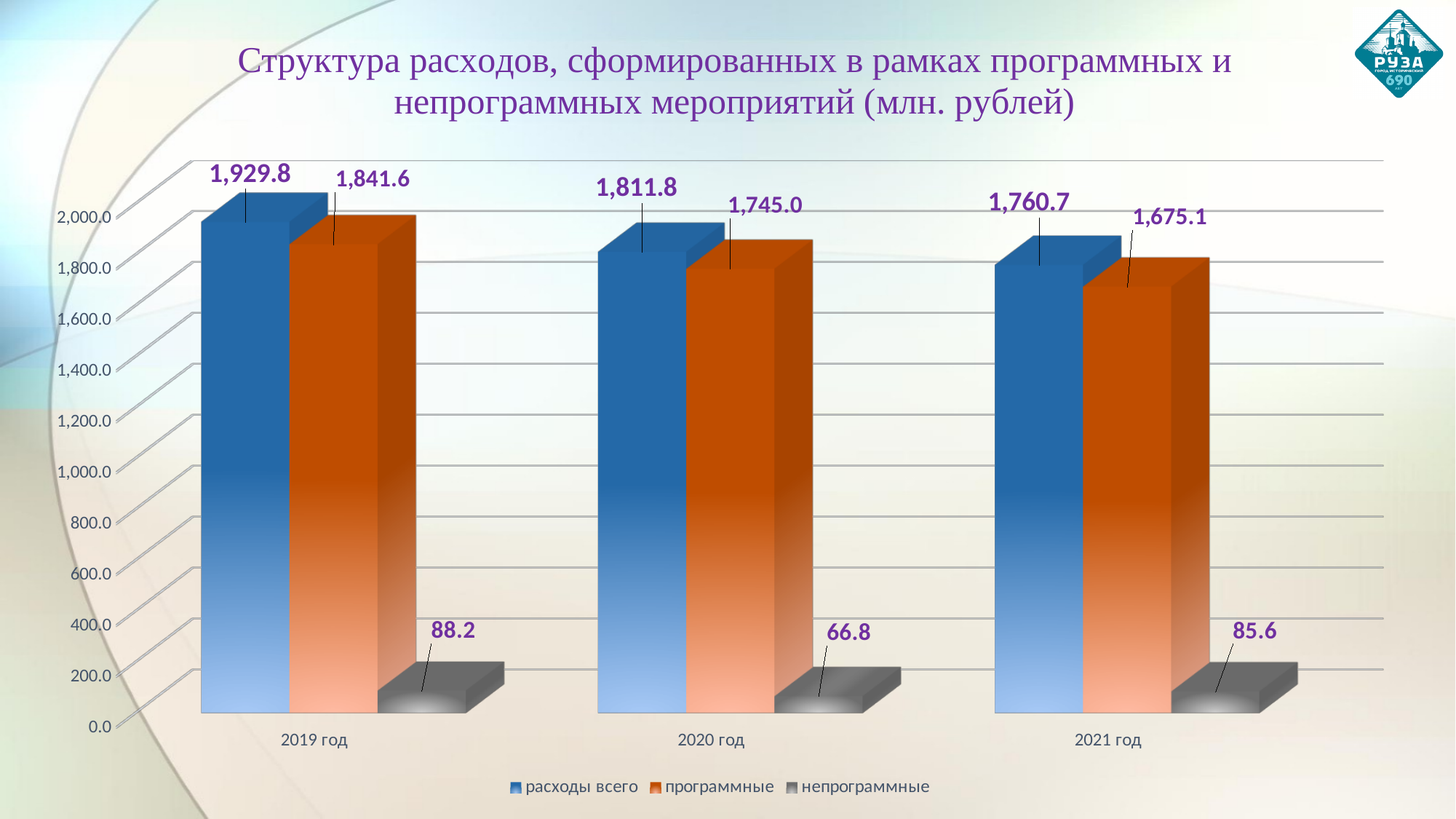
How many series does the legend list? 3 In which year is 'непрограммные' the lowest? 2020 год In which year is 'расходы всего' the highest? 2019 год What is the value of 'непрограммные' for 2021 год? 85.6 What is the value of 'программные' for 2020 год? 1,745.0 Does 'расходы всего' rise or fall from 2019 год to 2021 год? fall What is the difference between 'расходы всего' and 'программные' for 2021 год? 85.6 How many years are shown on the x axis? 3 What kind of chart is shown on the slide? bar chart What is the value of 'расходы всего' for 2019 год? 1,929.8 Is the value of 'программные' for 2021 год greater or less than 1,800.0? less Which is larger: 'непрограммные' for 2019 год or for 2021 год? 2019 год